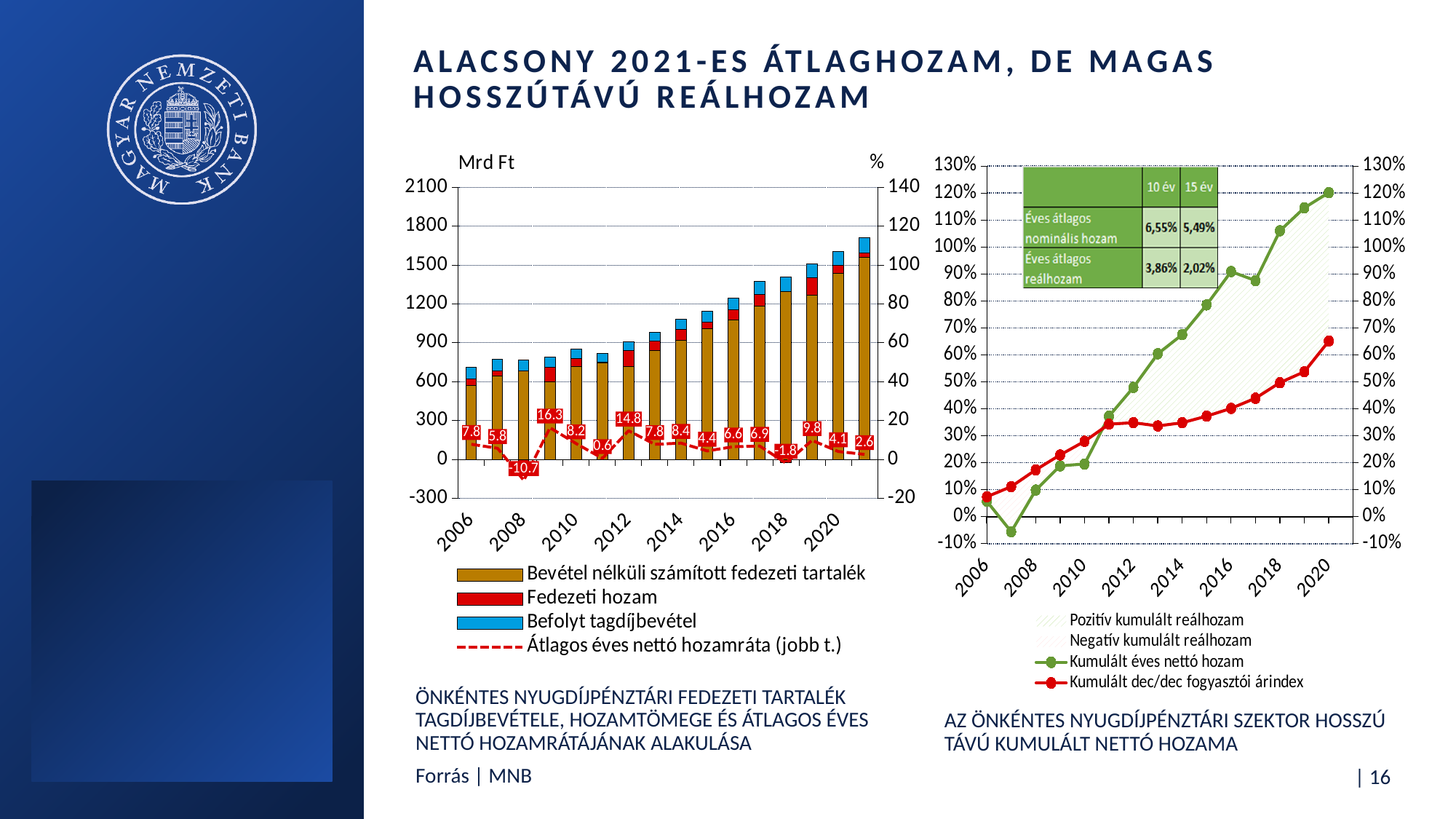
In the right chart, is the Kumulált éves nettó hozam value for 2007 greater or less than 0%? less In the right chart, how many entries does the legend list? 4 In the left chart, how many entries does the legend list? 4 In the left chart, what is the value of the Átlagos éves nettó hozamráta line for 2009? 16.3 In the left chart, what is the value of the Átlagos éves nettó hozamráta line for 2021? 2.6 In the left chart, in which year is the Átlagos éves nettó hozamráta lowest? 2008 In the right chart, is the Kumulált éves nettó hozam value for 2020 greater or less than 110%? greater In the right chart's inset table, what is the Éves átlagos nominális hozam for 10 év? 6,55% In the left chart, in which year is the Átlagos éves nettó hozamráta highest? 2009 In the left chart, what is the value of the Átlagos éves nettó hozamráta line for 2018? -1.8 In the right chart, which series is higher in 2020, Kumulált éves nettó hozam or Kumulált dec/dec fogyasztói árindex? Kumulált éves nettó hozam In the left chart, what is the difference between the Átlagos éves nettó hozamráta values for 2012 and 2013? 7.0